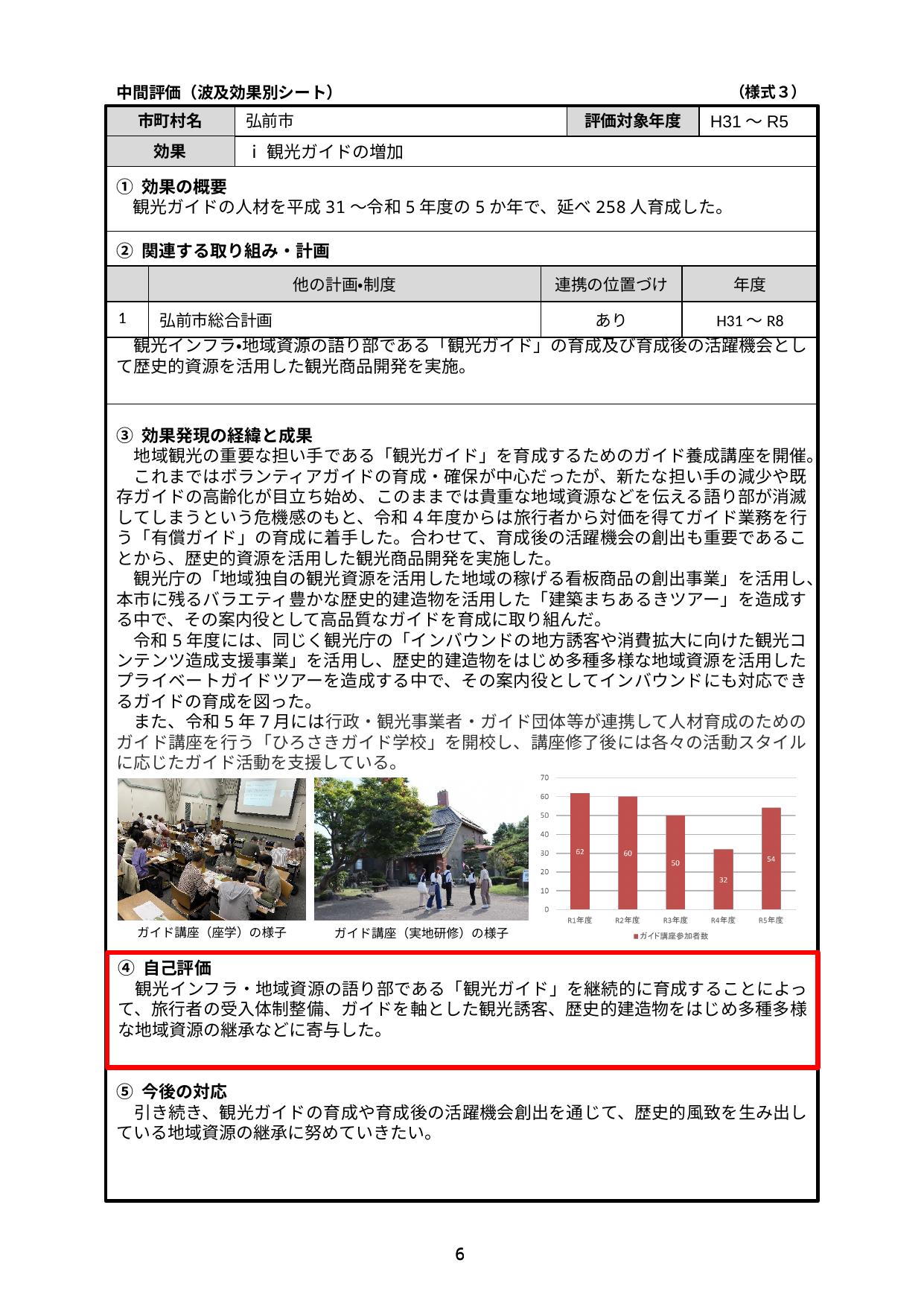
What is the difference between the values for R3年度 and R5年度 in the bar chart? 4 What kind of chart is shown on the slide? bar chart What series name does the legend of the bar chart show? ガイド講座参加者数 Which year has the lowest value in the bar chart? R4年度 What is the value for R5年度 in the bar chart? 54 Is the value for R4年度 in the bar chart greater or less than 40? less What is the value for R1年度 in the bar chart? 62 What is the value for R4年度 in the bar chart? 32 How many years are shown on the x axis of the bar chart? 5 Which year has the highest value in the bar chart? R1年度 Which is larger in the bar chart, the value for R3年度 or the value for R5年度? R5年度 What is the difference between the values for R1年度 and R4年度 in the bar chart? 30